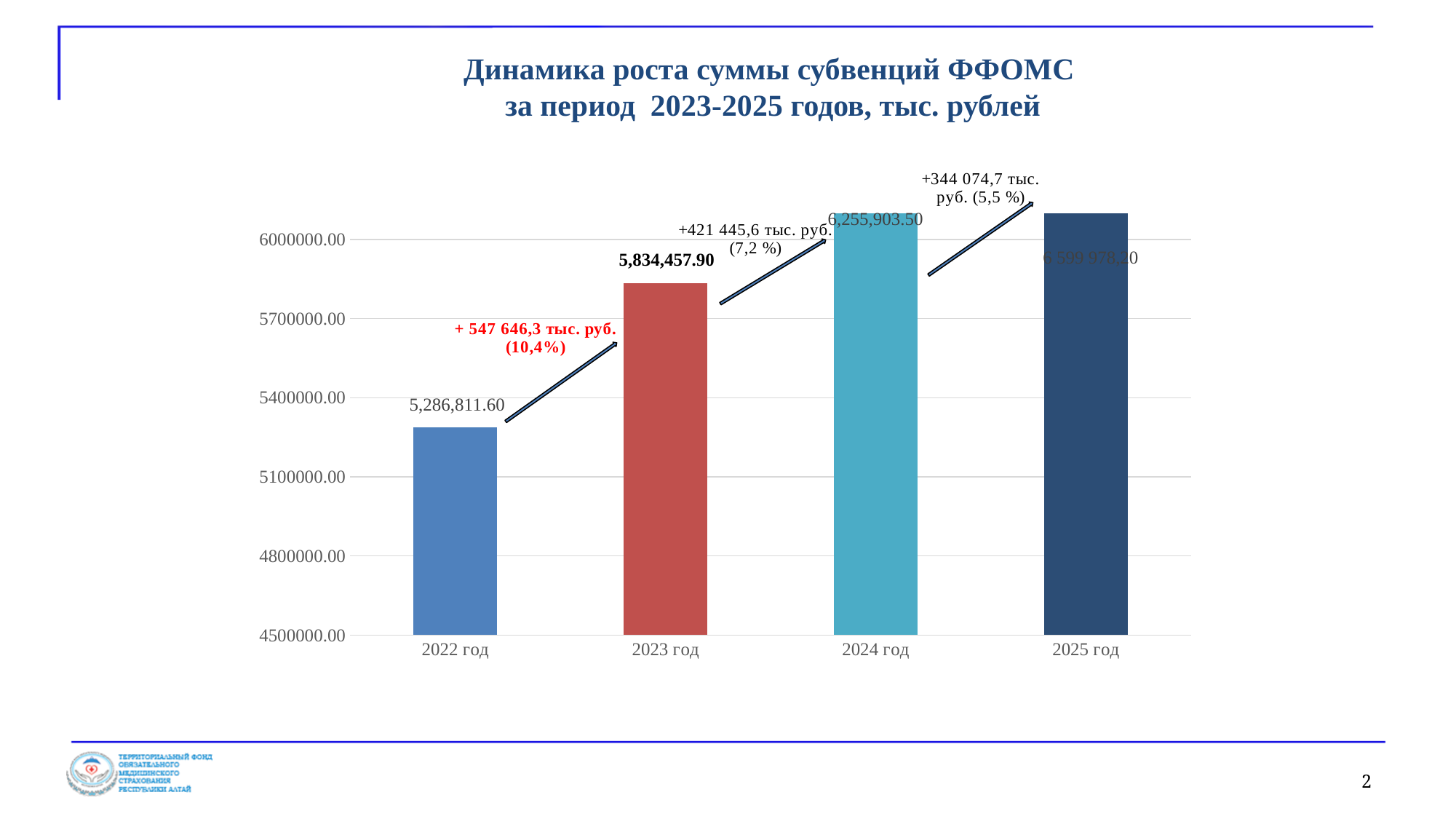
What is the value for 2022 год? 5,286,811.60 Do the values rise or fall from 2022 год to 2025 год? rise What is the difference between the values for 2023 год and 2022 год? 547,646.30 Which year has the highest value? 2025 год Which is larger, the value for 2023 год or for 2024 год? 2024 год Is the value for 2025 год greater or less than 6000000.00? greater What kind of chart is shown on the slide? bar chart What is the value for 2024 год? 6,255,903.50 What percentage growth is annotated between 2024 год and 2025 год? 5,5 % Which year has the lowest value? 2022 год What is the value for 2023 год? 5,834,457.90 How many bars are shown in the chart? 4